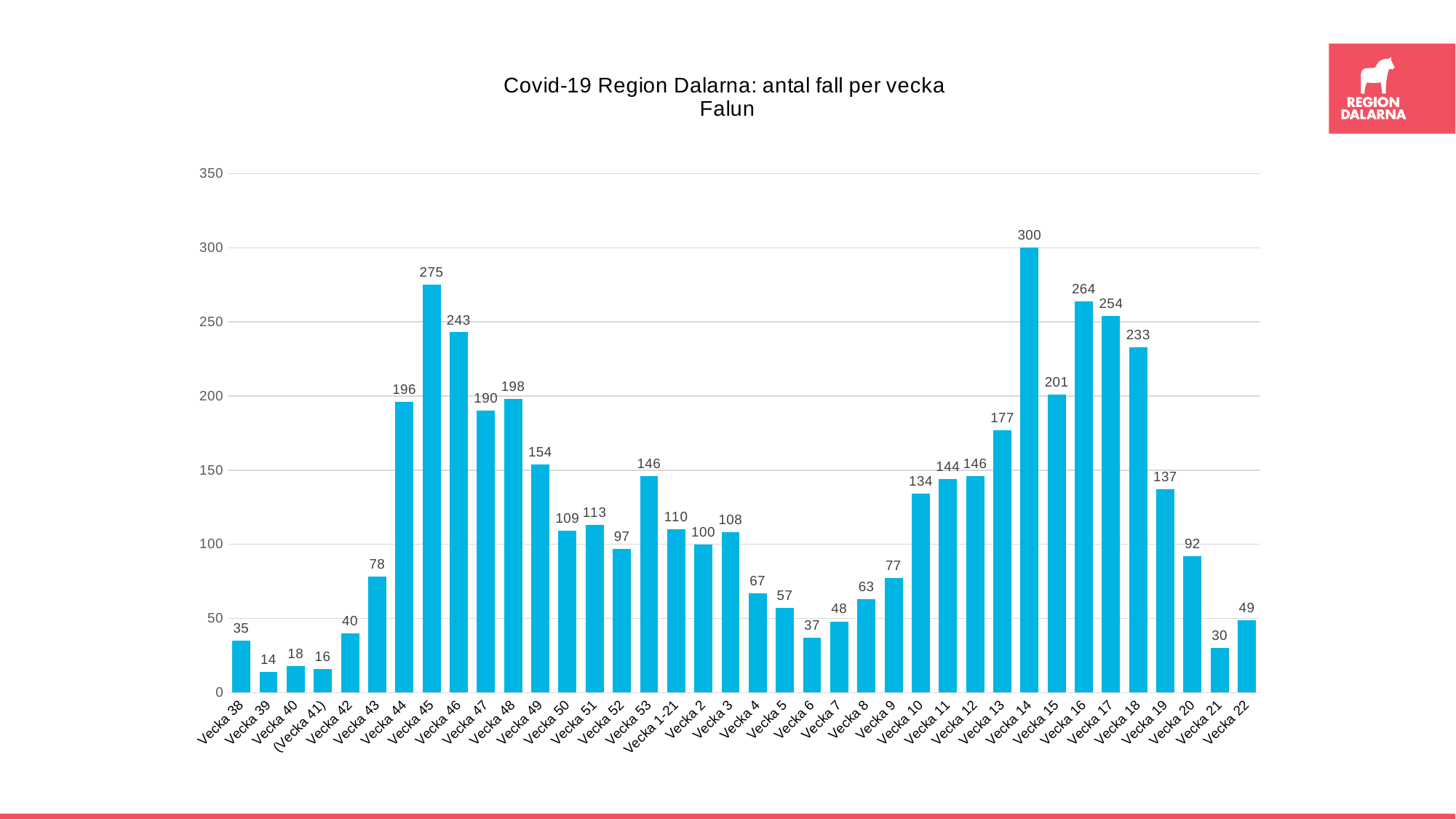
Which week has the highest number of cases? Vecka 14 What is the value for Vecka 45? 275 Which week has the lowest number of cases? Vecka 39 What is the value for Vecka 22? 49 What is the value for Vecka 6? 37 How many weeks (bars) are shown in the chart? 38 Which is larger, the value for Vecka 17 or the value for Vecka 18? Vecka 17 Is the value for Vecka 13 greater or less than 150? greater What is the difference between the values for Vecka 14 and Vecka 16? 36 What is the difference between the values for Vecka 45 and Vecka 46? 32 What kind of chart is shown on the slide? Bar chart What is the title of the chart? Covid-19 Region Dalarna: antal fall per vecka Falun